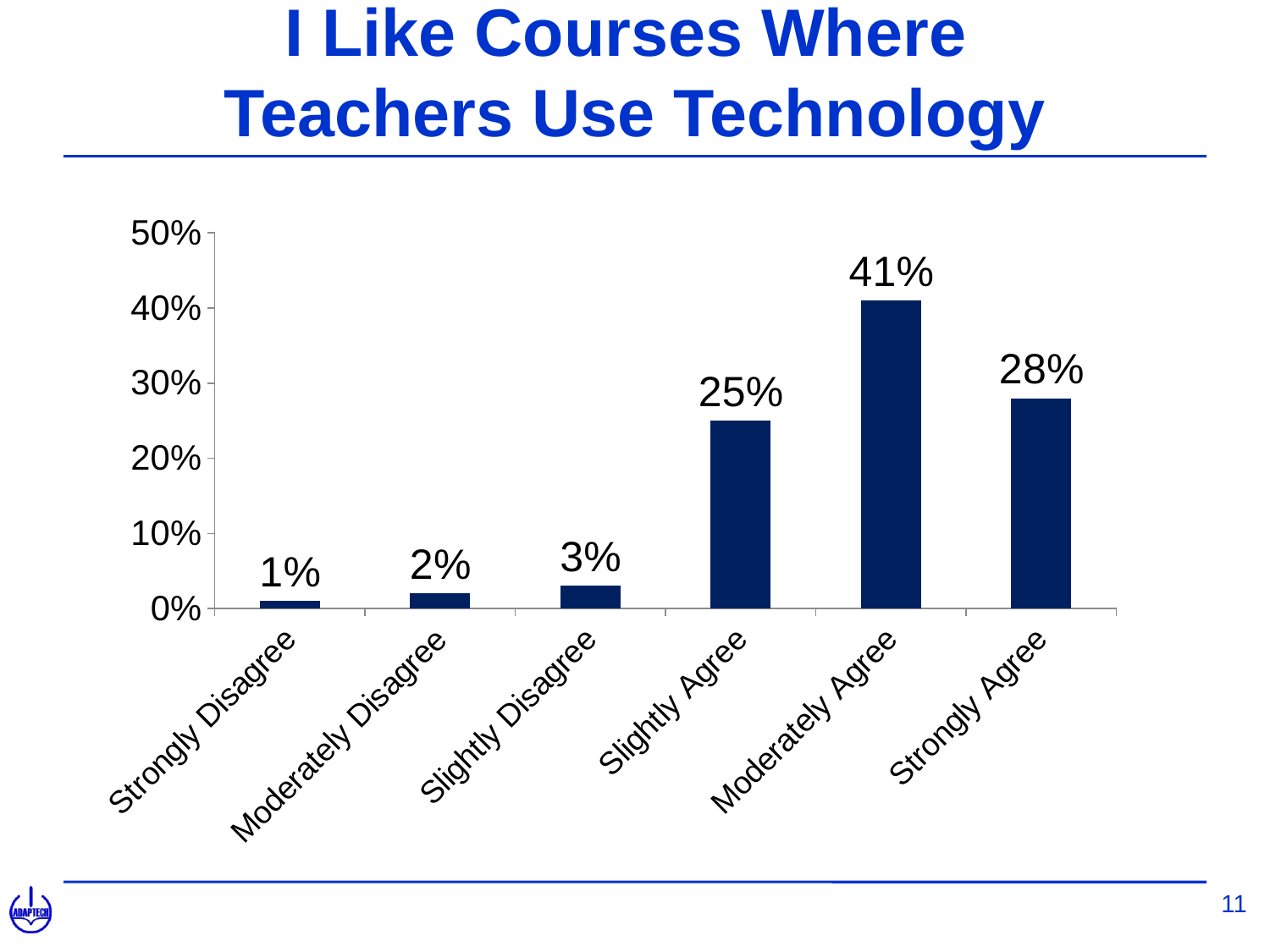
What is the difference between the values for Moderately Agree and Strongly Agree? 13% What kind of chart is shown on the slide? Bar chart How many categories are shown on the x axis? 6 What is the title of the slide? I Like Courses Where Teachers Use Technology What percentage of respondents chose Moderately Agree? 41% Which category has the highest value? Moderately Agree What is the difference between the values for Slightly Disagree and Moderately Disagree? 1% Which is larger, the value for Slightly Agree or the value for Strongly Agree? Strongly Agree Is the value for Moderately Agree greater or less than 40%? greater Which category has the lowest value? Strongly Disagree What is the value for Slightly Agree? 25% What is the value for Strongly Disagree? 1%